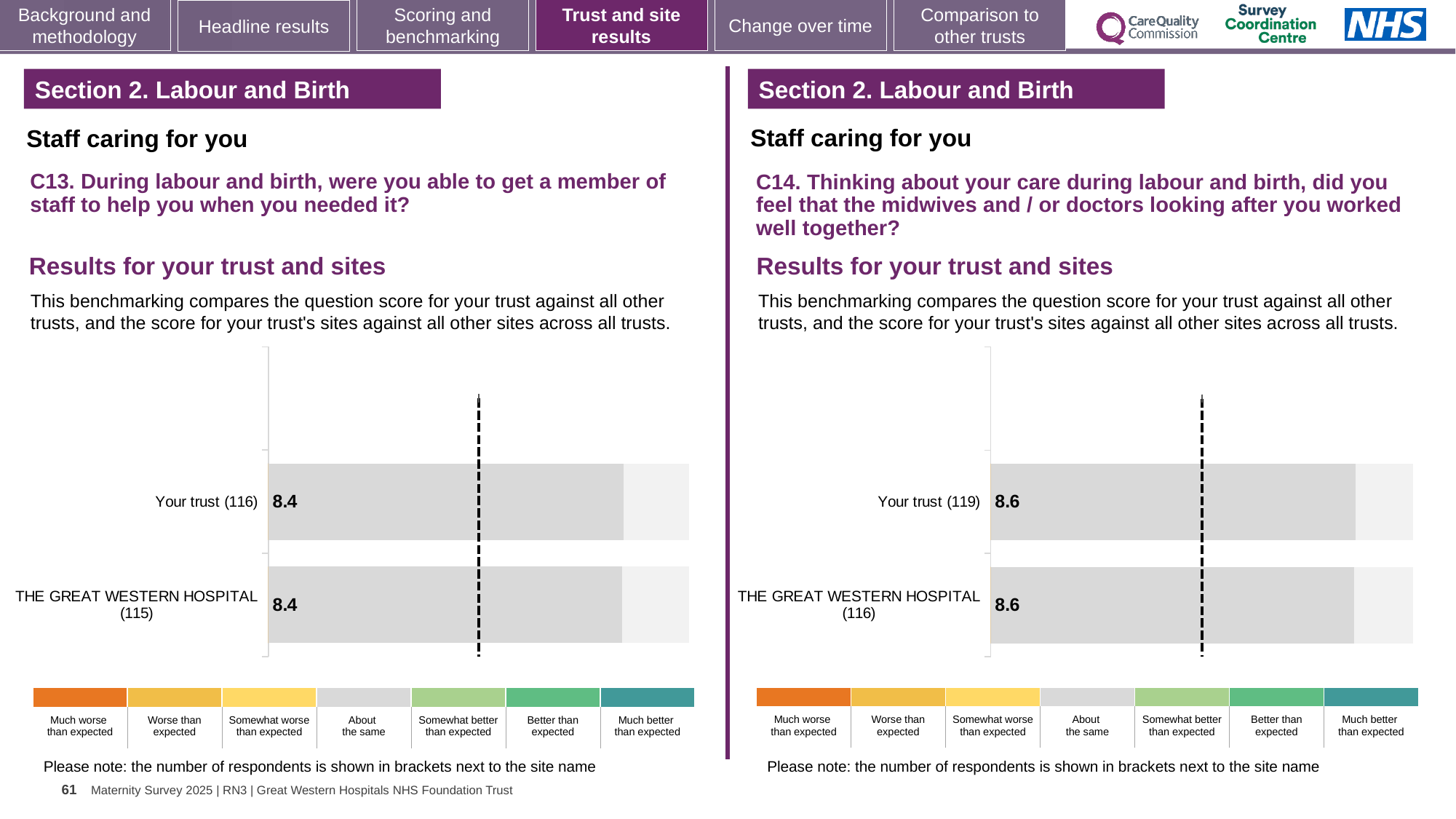
In the left chart (C13), how many respondents are shown in brackets for Your trust? 116 In the left chart (C13), what is the score for THE GREAT WESTERN HOSPITAL? 8.4 How many bars are plotted in the left chart (C13)? 2 In the right chart (C14), how many respondents are shown in brackets for THE GREAT WESTERN HOSPITAL? 116 In the left chart (C13), what is the score for Your trust? 8.4 In the right chart (C14), what is the score for Your trust? 8.6 In the right chart (C14), what is the difference between the score for Your trust and the score for THE GREAT WESTERN HOSPITAL? 0 In the left chart (C13), what is the difference between the score for Your trust and the score for THE GREAT WESTERN HOSPITAL? 0 Is the score for Your trust in the right chart (C14) larger or smaller than the score for Your trust in the left chart (C13)? Larger What kind of chart is used in the left chart (C13)? Bar chart In the right chart (C14), what is the score for THE GREAT WESTERN HOSPITAL? 8.6 How many bars are plotted in the right chart (C14)? 2